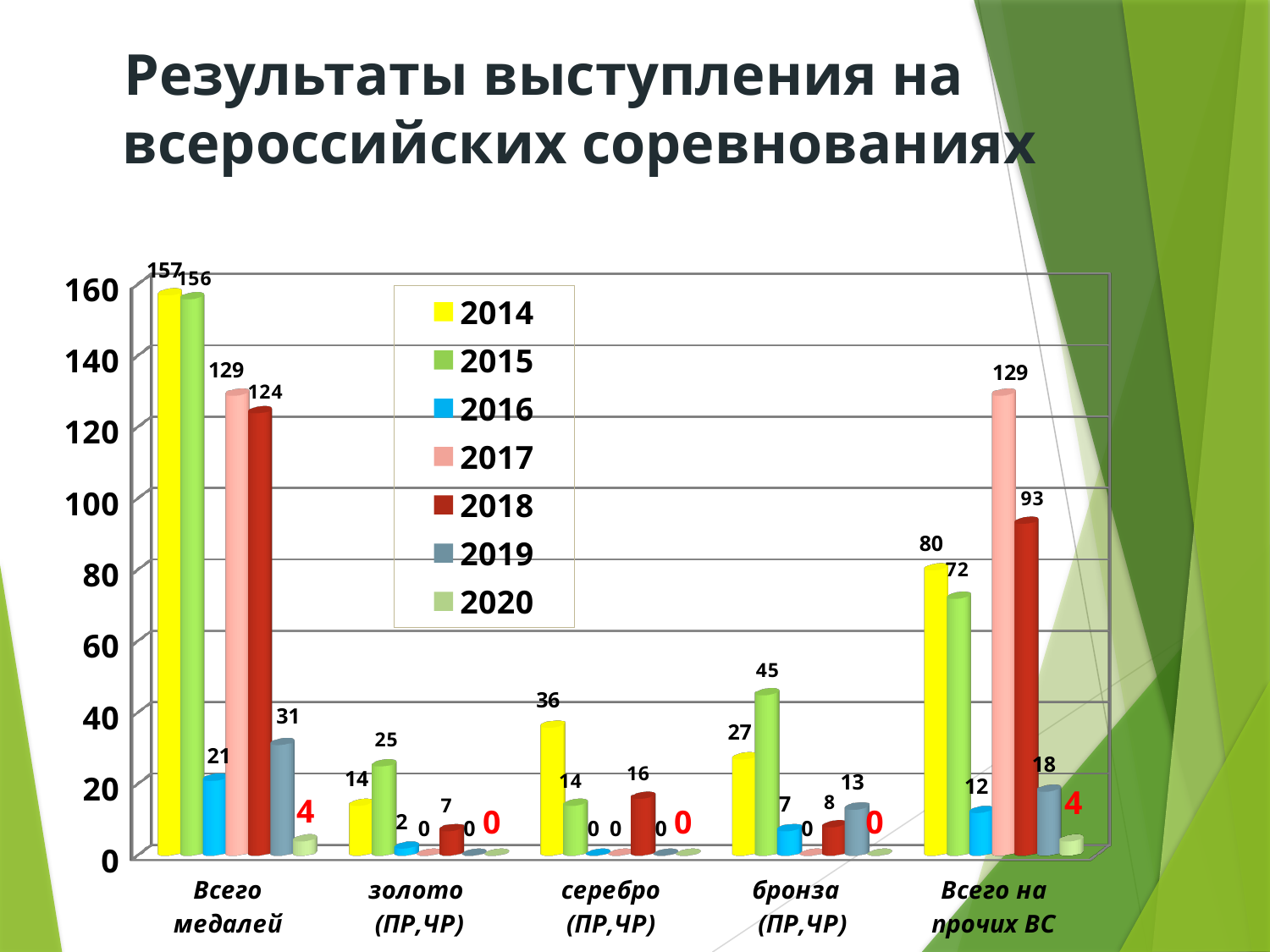
Which is larger in the "Всего на прочих ВС" category: the value for 2014 or the value for 2018? 2018 What is the value for 2015 in the "бронза (ПР,ЧР)" category? 45 What is the value for 2014 in the "Всего медалей" category? 157 How many categories are shown on the x axis? 5 Which year has the lowest value in the "Всего медалей" category? 2020 How many series does the legend list? 7 What kind of chart is shown on the slide? Bar chart What is the difference between the 2017 and 2018 values in the "Всего медалей" category? 5 What is the value for 2017 in the "Всего на прочих ВС" category? 129 Which year has the highest value in the "золото (ПР,ЧР)" category? 2015 Which year is represented by the yellow bars in the legend? 2014 What is the value for 2018 in the "серебро (ПР,ЧР)" category? 16